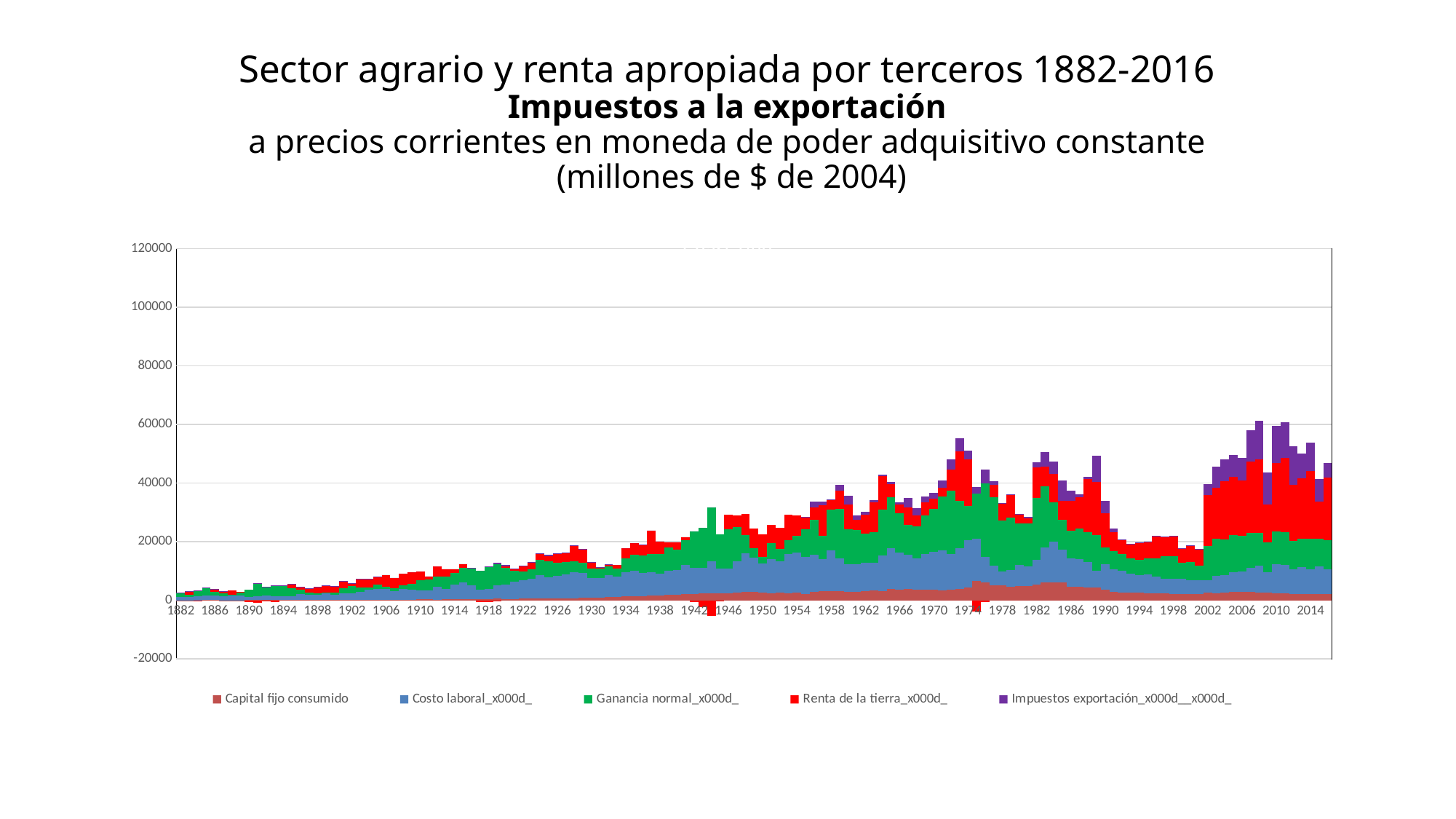
Which series is shown in purple in the legend? Impuestos exportación Which stacked bar is taller in total, the one for 2008 or the one for 1994? 2008 Overall, do the stacked bar totals rise or fall from 1882 to 2016? rise What is the first series listed in the legend? Capital fijo consumido Is the total height of the stacked bar for 1882 greater or less than 20000? less Is the total height of the stacked bar for 1906 greater or less than 20000? less Which stacked bar is taller in total, the one for 1882 or the one for 1966? 1966 Is the total height of the stacked bar for 2008 greater or less than 40000? greater How many series does the legend list? 5 What kind of chart is shown on the slide? stacked bar chart